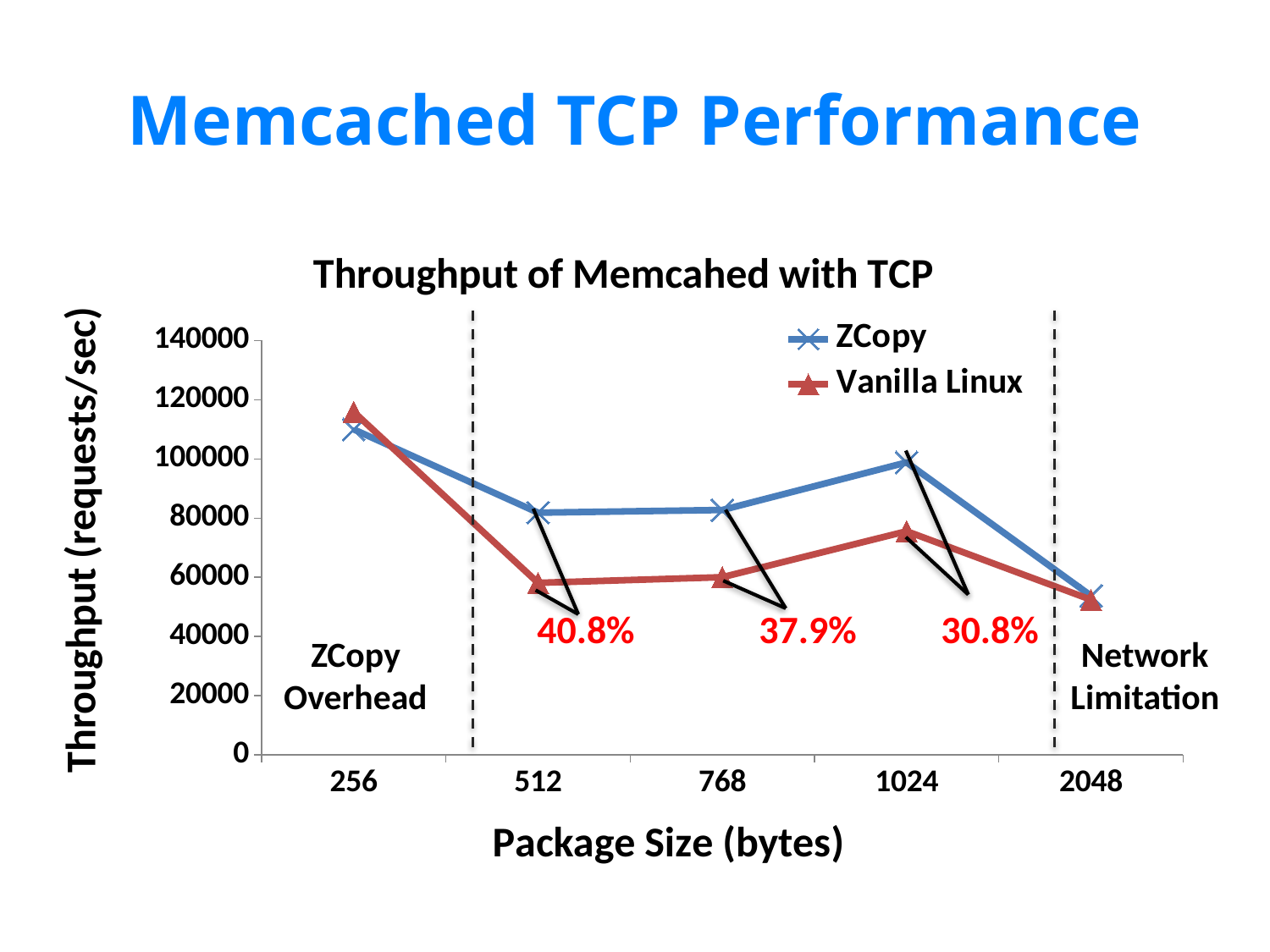
Is the ZCopy throughput at package size 1024 greater or less than 80000? greater Is the ZCopy throughput at package size 256 greater or less than 100000? greater How many package sizes are plotted along the x axis? 5 At package size 1024, which series has the higher throughput, ZCopy or Vanilla Linux? ZCopy Does the ZCopy throughput rise or fall from package size 1024 to 2048? fall Is the Vanilla Linux throughput at package size 1024 greater or less than 80000? less What percentage is annotated between the two series at package size 512? 40.8% How many series does the legend list? 2 At which package size does ZCopy have its lowest throughput? 2048 What is the title of the chart? Throughput of Memcahed with TCP At which package size does ZCopy reach its highest throughput? 256 What kind of chart is shown on the slide? line chart